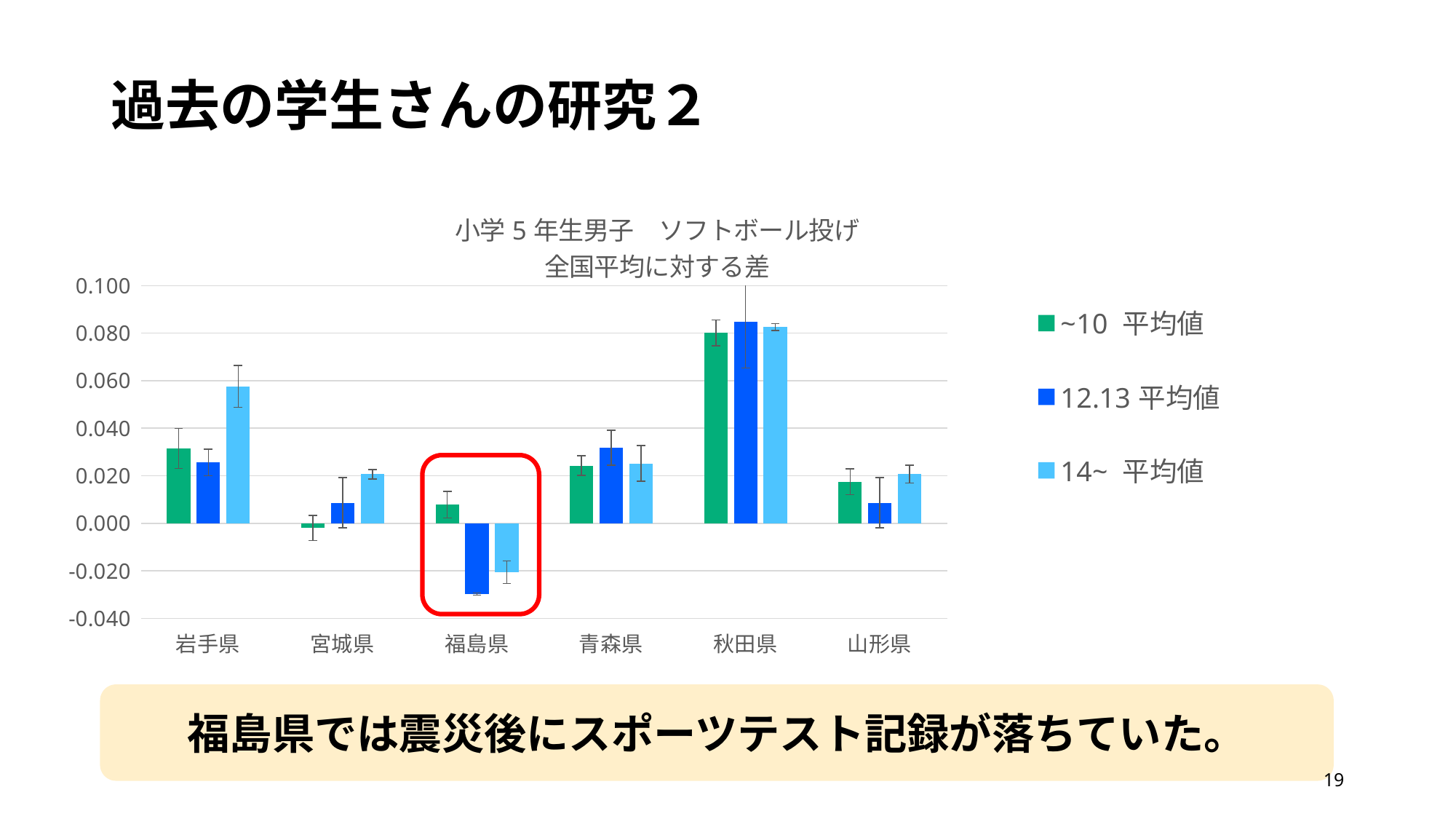
Which prefecture's bars are highlighted with a red box on the chart? 福島県 Is the ~10 平均値 value for 秋田県 greater or less than 0.060? greater What kind of chart is shown on the slide? bar chart Which prefecture has the lowest value for the 12.13 平均値 series? 福島県 Is the 12.13 平均値 value for 福島県 greater or less than -0.020? less For 岩手県, which is larger: the 12.13 平均値 value or the 14~ 平均値 value? 14~ 平均値 How many prefectures are shown on the x axis of the chart? 6 For 福島県, which is larger: the ~10 平均値 value or the 12.13 平均値 value? ~10 平均値 Which prefecture has the lowest value for the 14~ 平均値 series? 福島県 Is the 14~ 平均値 value for 宮城県 greater or less than 0.040? less Which prefecture has the highest value for the ~10 平均値 series? 秋田県 How many series does the chart legend list? 3